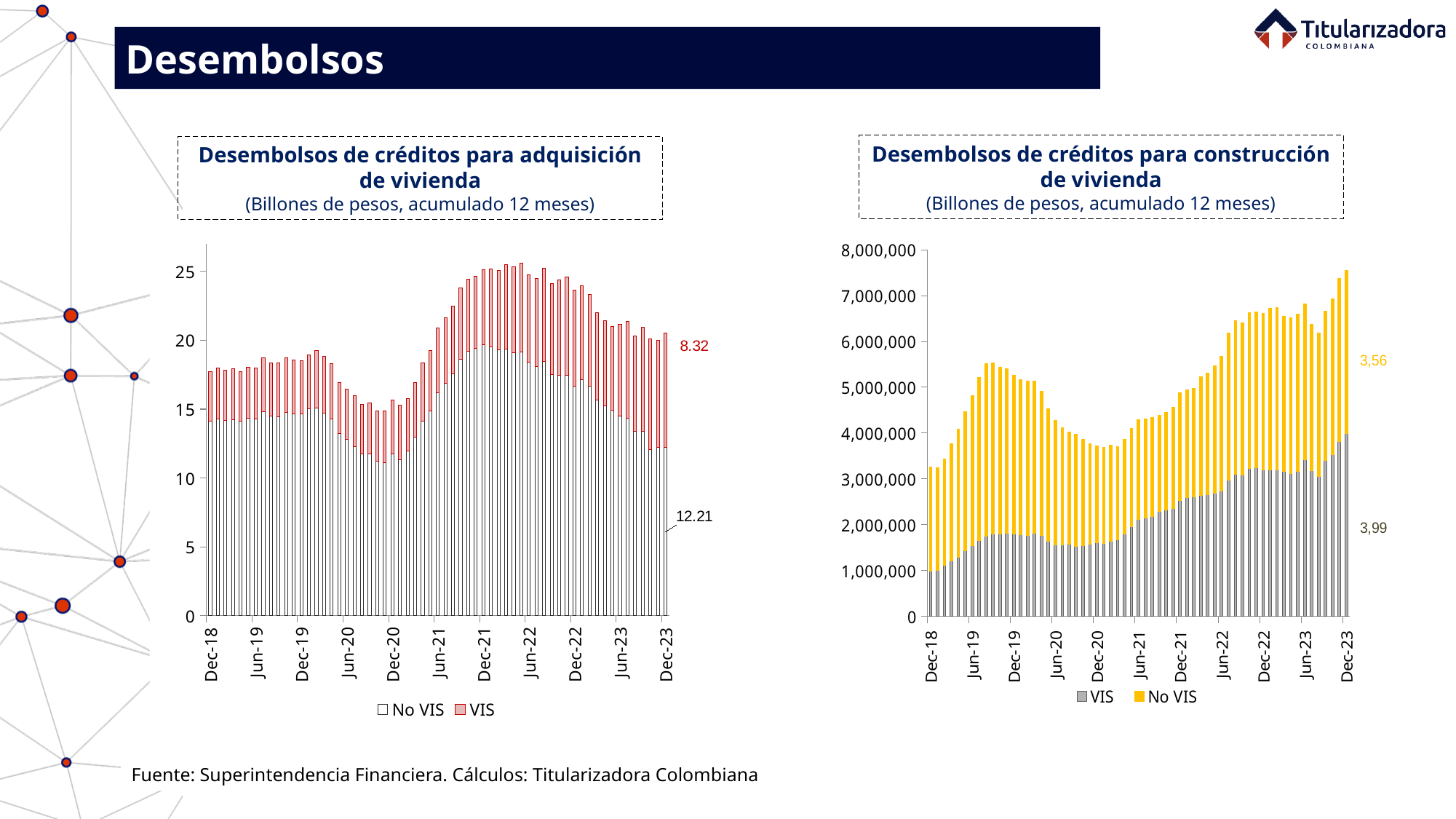
In the left chart (adquisición de vivienda), what is the difference between the No VIS and VIS labelled values at Dec-23? 3.89 How many series does the legend of the right chart (construcción de vivienda) list? 2 What kind of chart is the left chart (Desembolsos de créditos para adquisición de vivienda)? Stacked bar chart In the left chart (Desembolsos de créditos para adquisición de vivienda), what is the labelled No VIS value at Dec-23? 12.21 In the left chart (adquisición de vivienda), what is the total of the Dec-23 stacked bar using the printed labels? 20.53 In the left chart (adquisición de vivienda), which series has the larger value at Dec-23, No VIS or VIS? No VIS In the right chart (construcción de vivienda), which series has the larger value at Dec-23, VIS or No VIS? VIS In the left chart (adquisición de vivienda), is the No VIS value at Dec-20 greater or less than 15? less In the right chart (Desembolsos de créditos para construcción de vivienda), what is the labelled VIS value at Dec-23? 3,99 In the left chart (Desembolsos de créditos para adquisición de vivienda), what is the labelled VIS value at Dec-23? 8.32 In the right chart (construcción de vivienda), is the total height of the Dec-23 stacked bar greater or less than 7,000,000? greater In the right chart (Desembolsos de créditos para construcción de vivienda), what is the labelled No VIS value at Dec-23? 3,56